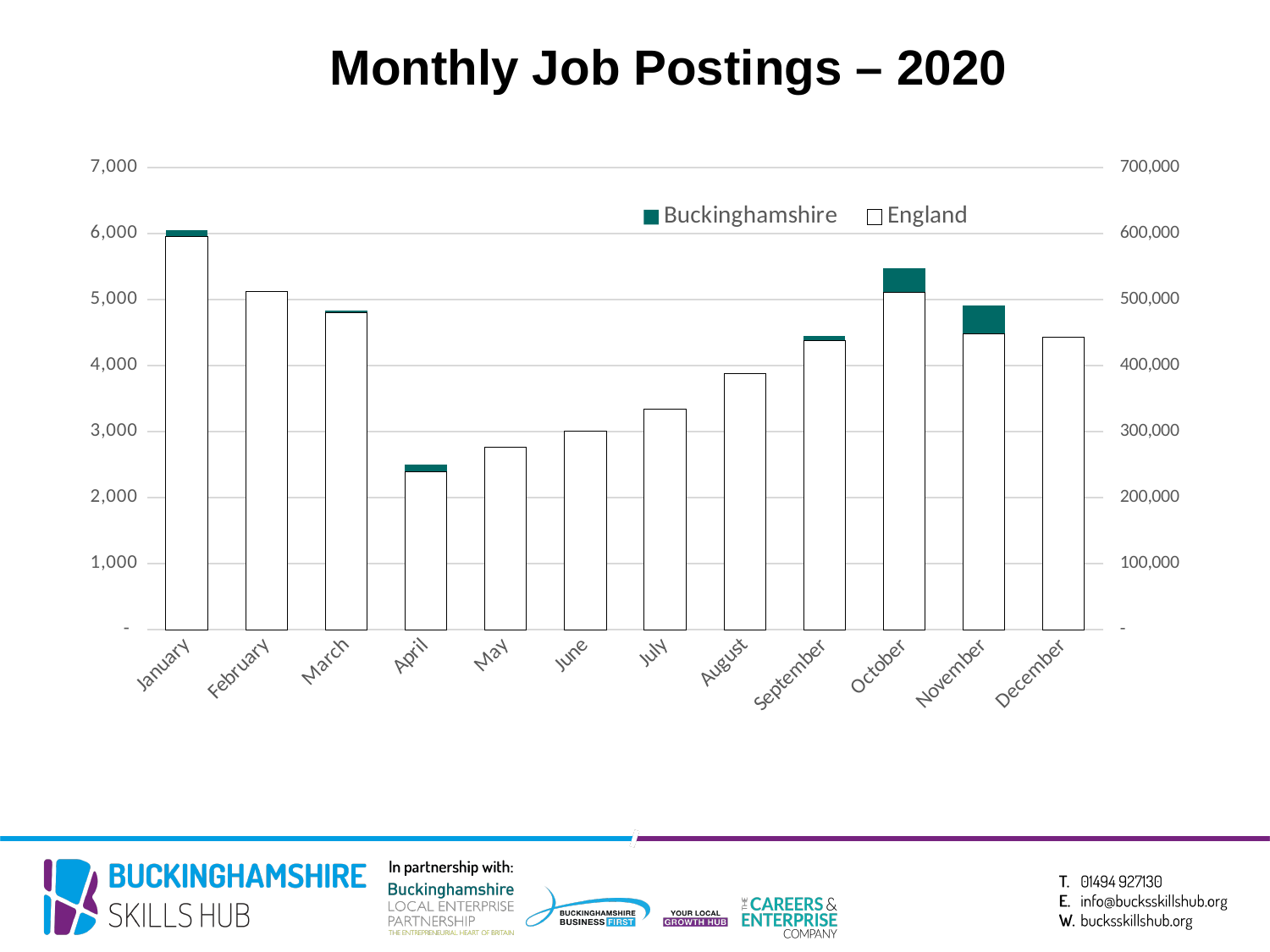
What kind of chart is shown on the slide? Bar chart How many months are shown along the x axis? 12 Do the England values rise or fall from April to October? Rise Is the Buckinghamshire value for October greater or less than 5,000? greater Which month has the lowest England job postings value? April Is the Buckinghamshire value for April greater or less than 3,000? less Which month has the highest England job postings value? January Which month has the higher England value, February or March? February Is the England value for April greater or less than 300,000? less What is the title of the chart? Monthly Job Postings – 2020 How many series does the legend list? 2